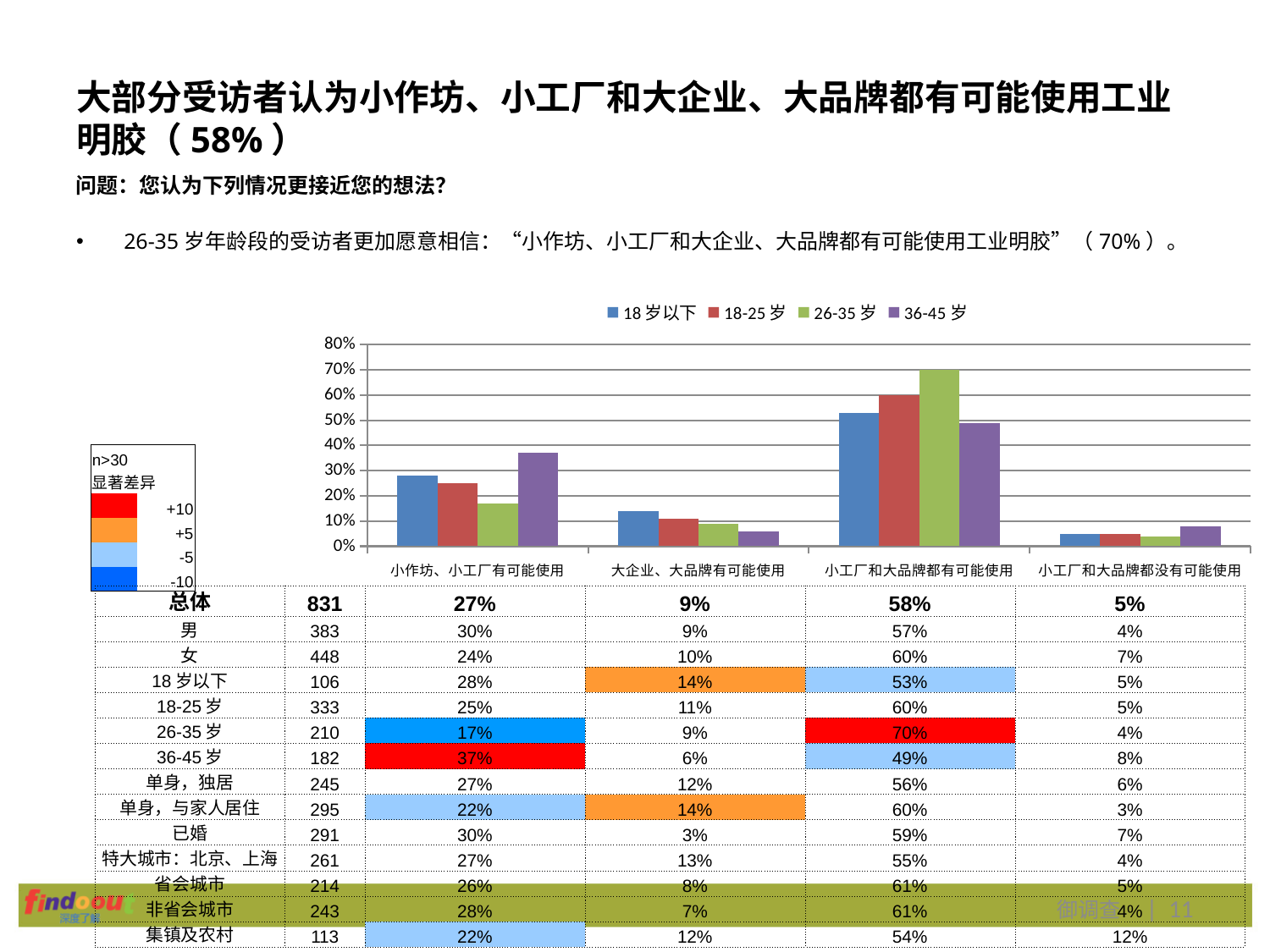
What is the value for 18-25 岁 in the category 小工厂和大品牌都有可能使用? 60% Which age group has the highest bar for 小工厂和大品牌都有可能使用? 26-35 岁 What is the first entry listed in the chart legend? 18 岁以下 Which age group has the highest bar for 小作坊、小工厂有可能使用? 36-45 岁 How many categories are shown along the x axis of the chart? 4 Which age group has the lowest bar for 小作坊、小工厂有可能使用? 26-35 岁 What is the value for 26-35 岁 in the category 小工厂和大品牌都有可能使用? 70% What kind of chart is shown on the slide? bar chart Is the value for 18 岁以下 in 小作坊、小工厂有可能使用 greater or less than 20%? greater Is the value for 36-45 岁 in 大企业、大品牌有可能使用 greater or less than 10%? less In the category 小工厂和大品牌都有可能使用, which is larger: the bar for 18 岁以下 or the bar for 36-45 岁? 18 岁以下 How many series does the chart legend list? 4